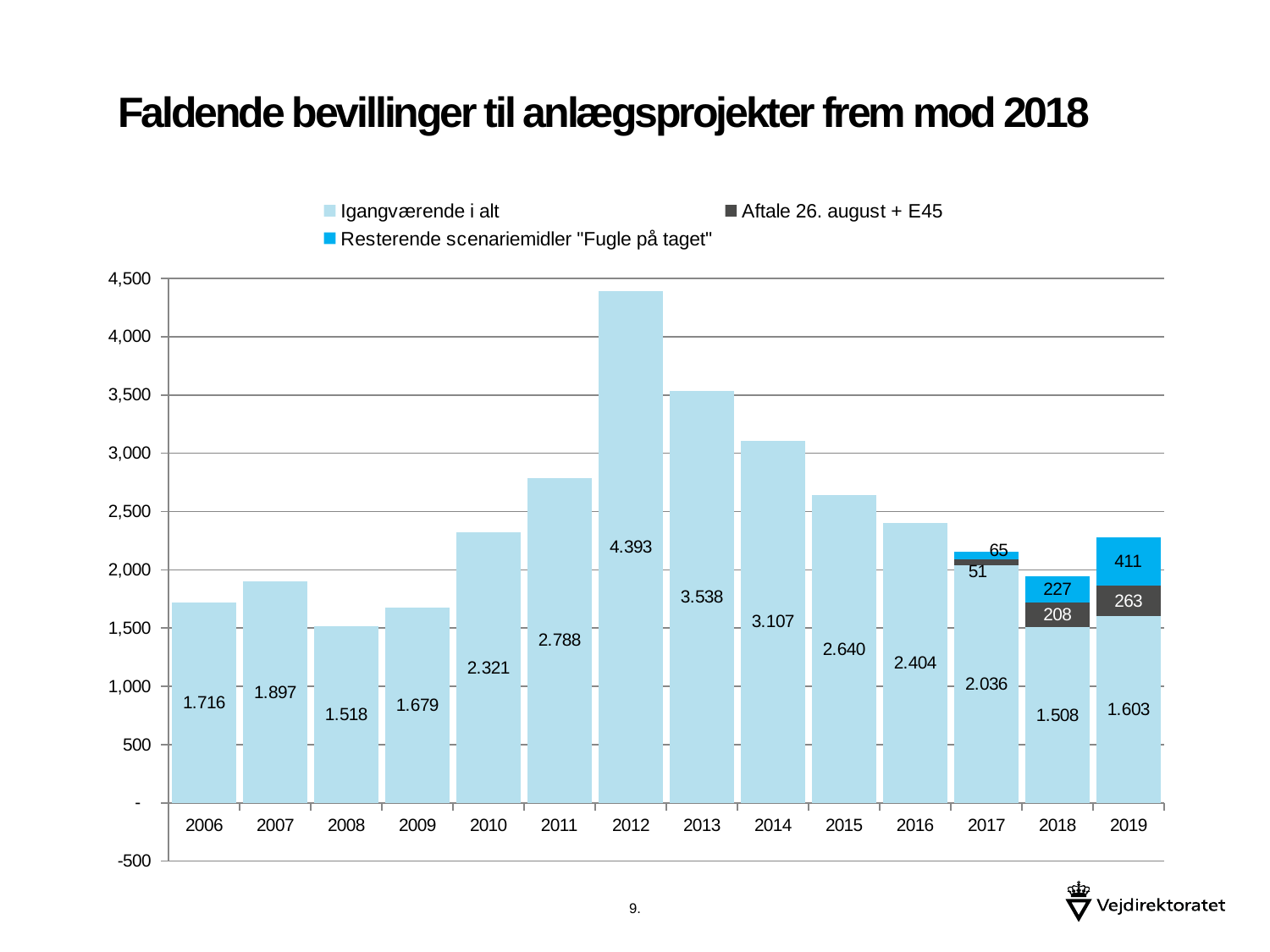
Which year has the lowest value for "Igangværende i alt"? 2018 How many series does the legend list? 3 Which year has the highest value for "Igangværende i alt"? 2012 What is the value of "Igangværende i alt" for 2008? 1.518 What is the difference between the "Igangværende i alt" values for 2012 and 2013? 855 What kind of chart is shown on the slide? Stacked bar chart Which is larger, the "Igangværende i alt" value for 2010 or for 2016? 2016 How many years are shown on the x axis? 14 What is the total height of the stacked bar for 2019? 2.277 What is the value of "Aftale 26. august + E45" for 2019? 263 What is the value of "Igangværende i alt" for 2012? 4.393 What is the value of "Resterende scenariemidler "Fugle på taget"" for 2018? 227